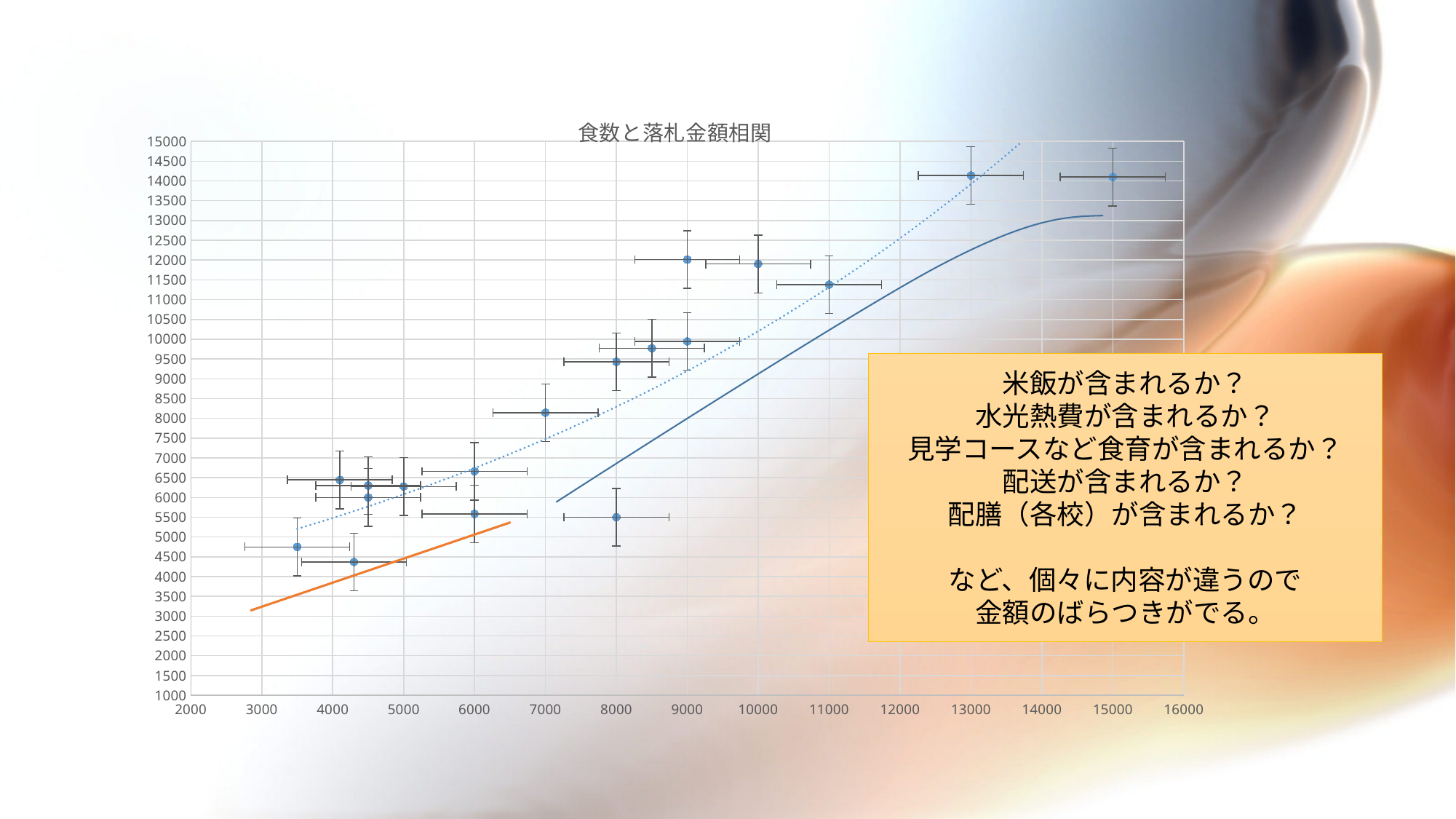
What kind of chart is shown on the slide? scatter chart Do the plotted values generally rise or fall as the x-axis value increases? rise Is the value for the point at x = 13000 greater or less than 13000? greater Is the value for the point at x = 3500 greater or less than 5500? less What is the maximum value shown on the y-axis? 15000 What is the title of the chart? 食数と落札金額相関 Is the value for the point at x = 11000 greater or less than 10000? greater What is the maximum value shown on the x-axis? 16000 Which has the larger plotted value: the point at x = 10000 or the point at x = 7000? the point at x = 10000